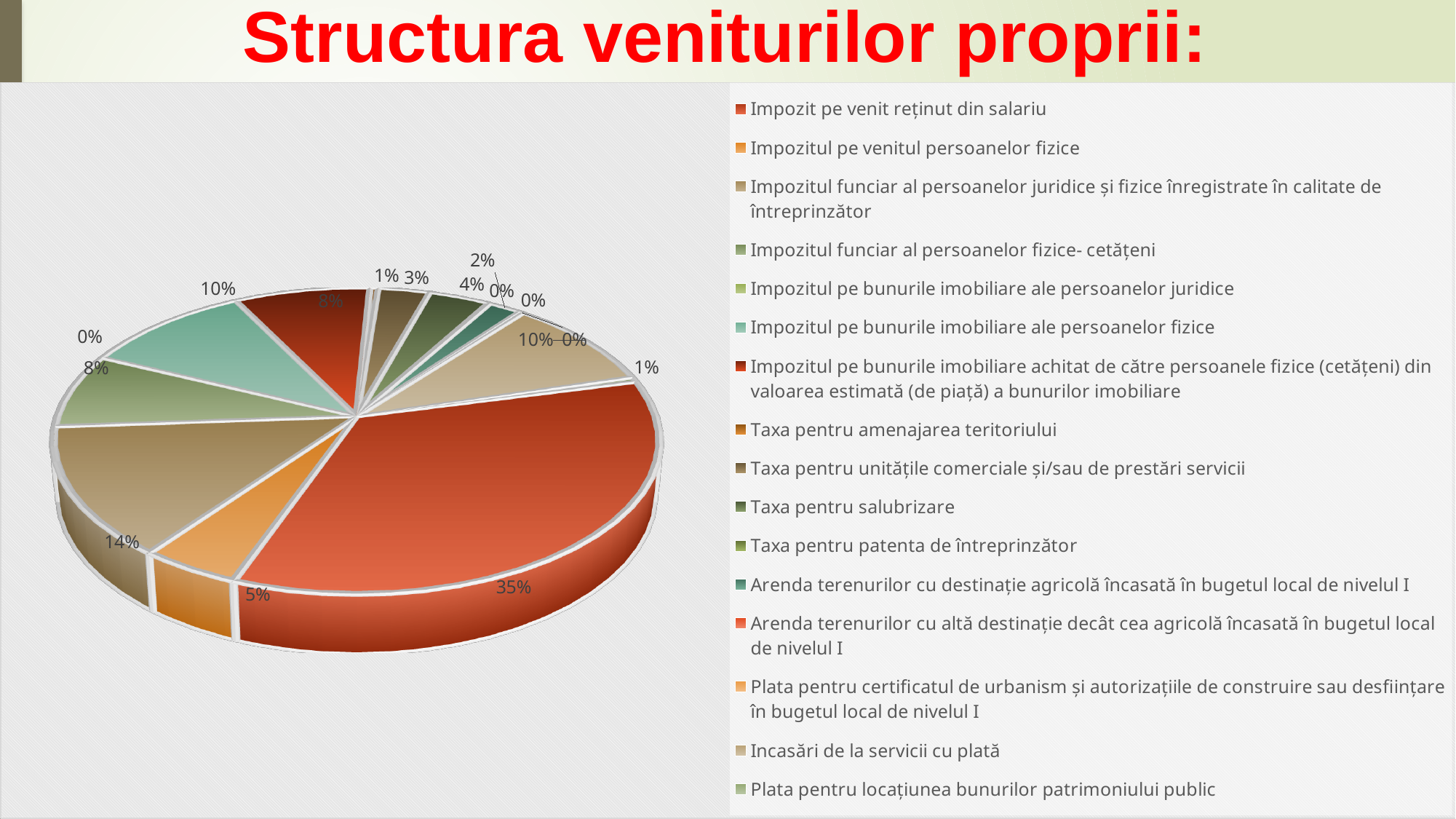
What kind of chart is shown on the slide? pie chart What share of the pie does 'Impozit pe venit reținut din salariu' represent? 35% What share of the pie does 'Impozitul funciar al persoanelor juridice și fizice înregistrate în calitate de întreprinzător' represent? 14% Which is larger: the slice for 'Impozit pe venit reținut din salariu' or the slice for 'Impozitul funciar al persoanelor juridice și fizice înregistrate în calitate de întreprinzător'? Impozit pe venit reținut din salariu How many slices of the pie chart are labelled 0%? 4 What is the difference in percentage points between the 35% slice and the 5% slice? 30 How many entries does the legend of the pie chart list? 16 Which category has the largest slice of the pie chart? Impozit pe venit reținut din salariu What is the title of the slide containing the pie chart? Structura veniturilor proprii: What share of the pie does 'Impozitul pe venitul persoanelor fizice' represent? 5% What is the largest share shown on the pie chart? 35%